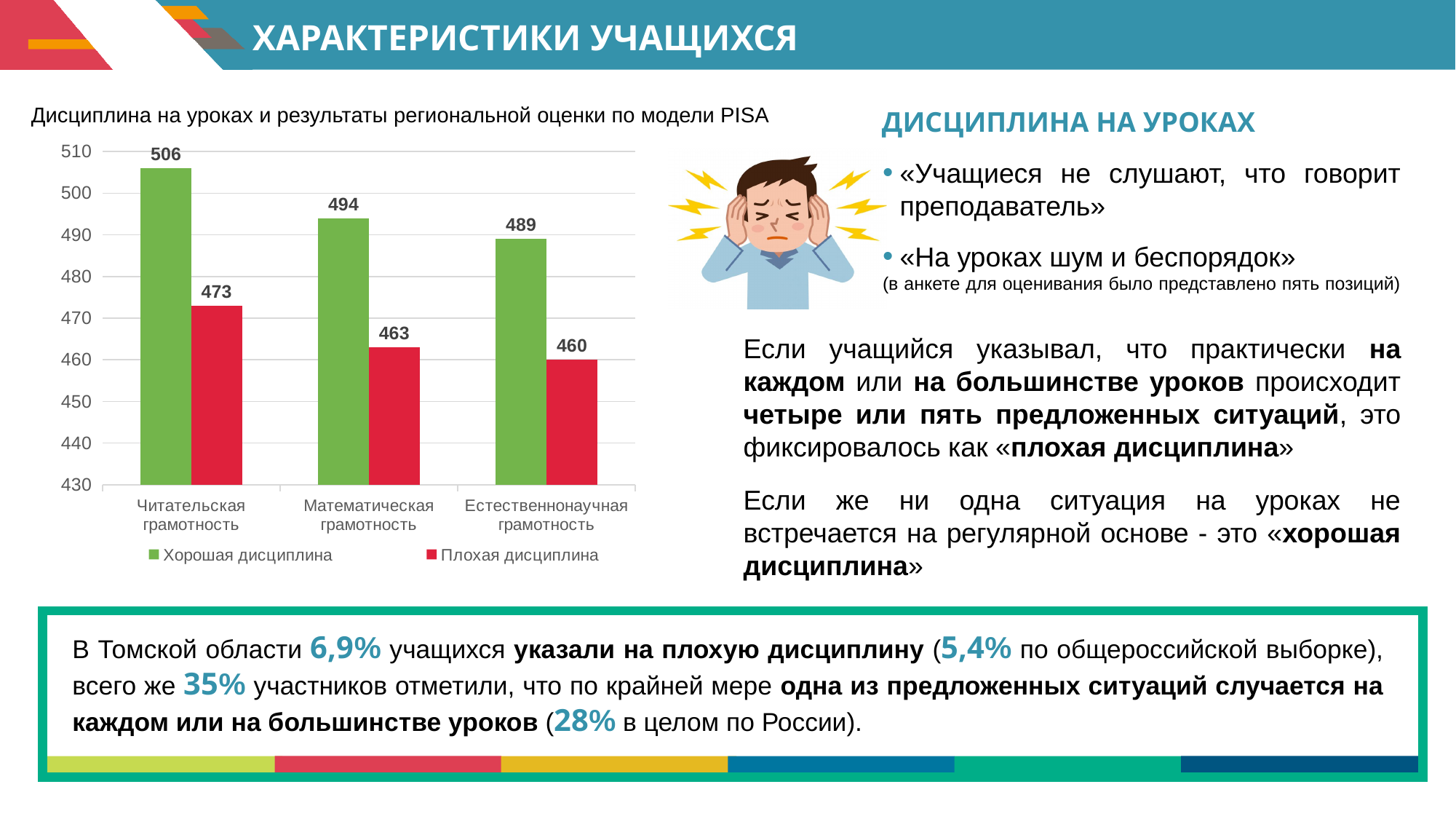
What is the value for «Плохая дисциплина» in «Математическая грамотность»? 463 How many series does the chart legend list? 2 Which is larger: «Хорошая дисциплина» in «Естественнонаучная грамотность» or «Плохая дисциплина» in «Читательская грамотность»? Хорошая дисциплина in Естественнонаучная грамотность What is the value for «Плохая дисциплина» in «Естественнонаучная грамотность»? 460 What is the difference between «Хорошая дисциплина» and «Плохая дисциплина» in «Читательская грамотность»? 33 Which category has the lowest value for «Плохая дисциплина»? Естественнонаучная грамотность What is the difference between «Хорошая дисциплина» and «Плохая дисциплина» in «Математическая грамотность»? 31 How many categories are shown on the x axis of the chart? 3 What is the value for «Хорошая дисциплина» in «Читательская грамотность»? 506 Which category has the highest value for «Хорошая дисциплина»? Читательская грамотность What kind of chart is shown on the slide? Bar chart Do the values for «Хорошая дисциплина» rise or fall from left to right along the x axis? Fall